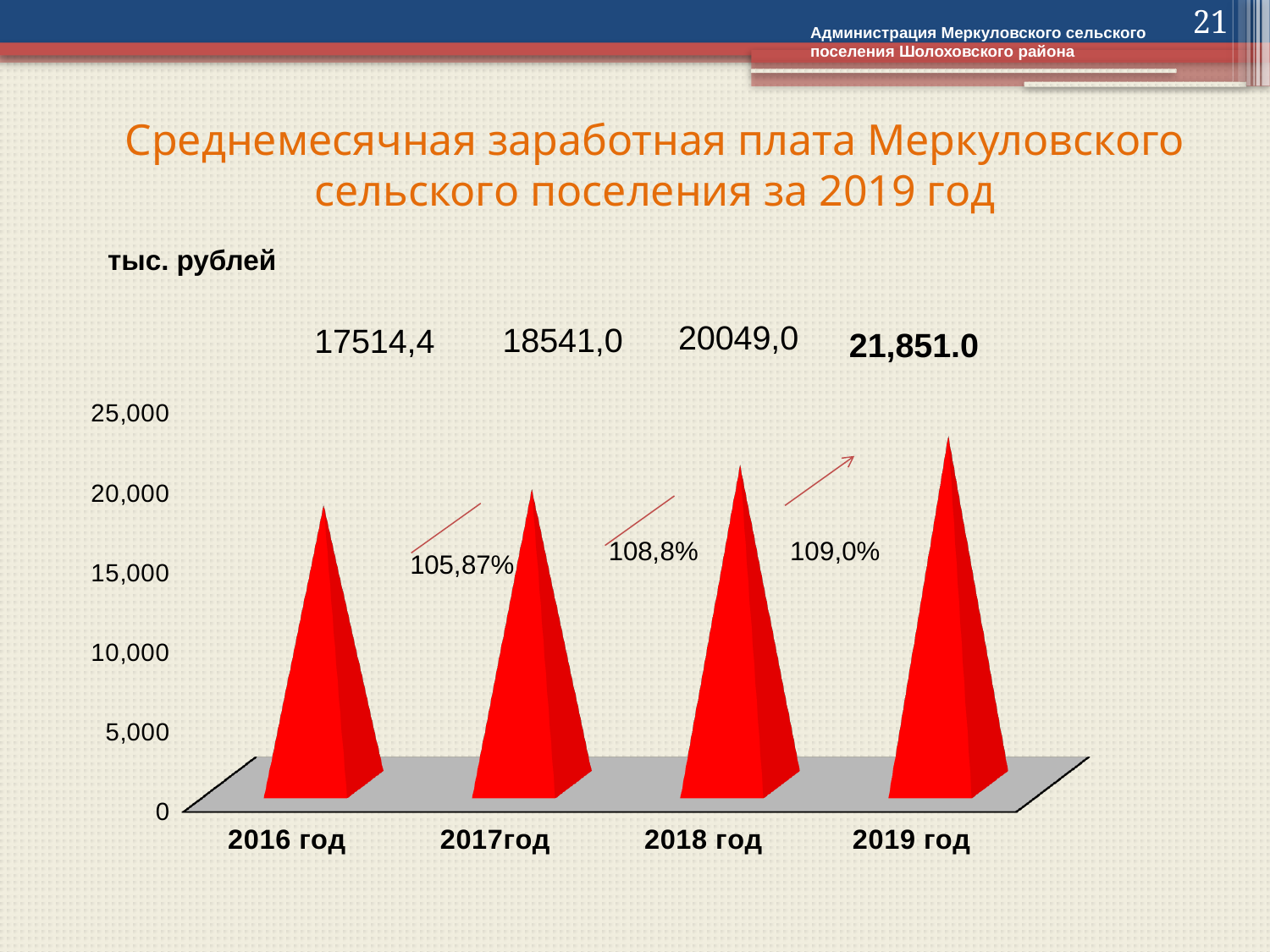
Which year has the lowest average monthly salary? 2016 год How many years (categories) are plotted on the chart? 4 What is the average monthly salary value shown for 2016 год? 17514,4 What growth percentage is shown between 2018 год and 2019 год? 109,0% What is the difference between the values for 2018 год and 2017год? 1508,0 What kind of chart is shown on the slide? bar chart Which year has the highest average monthly salary? 2019 год What is the value shown for 2018 год? 20049,0 What is the value shown for 2019 год? 21,851.0 Do the values rise or fall from 2016 год to 2019 год? rise What is the value shown for 2017год? 18541,0 Is the value for 2016 год greater or less than 20,000? less